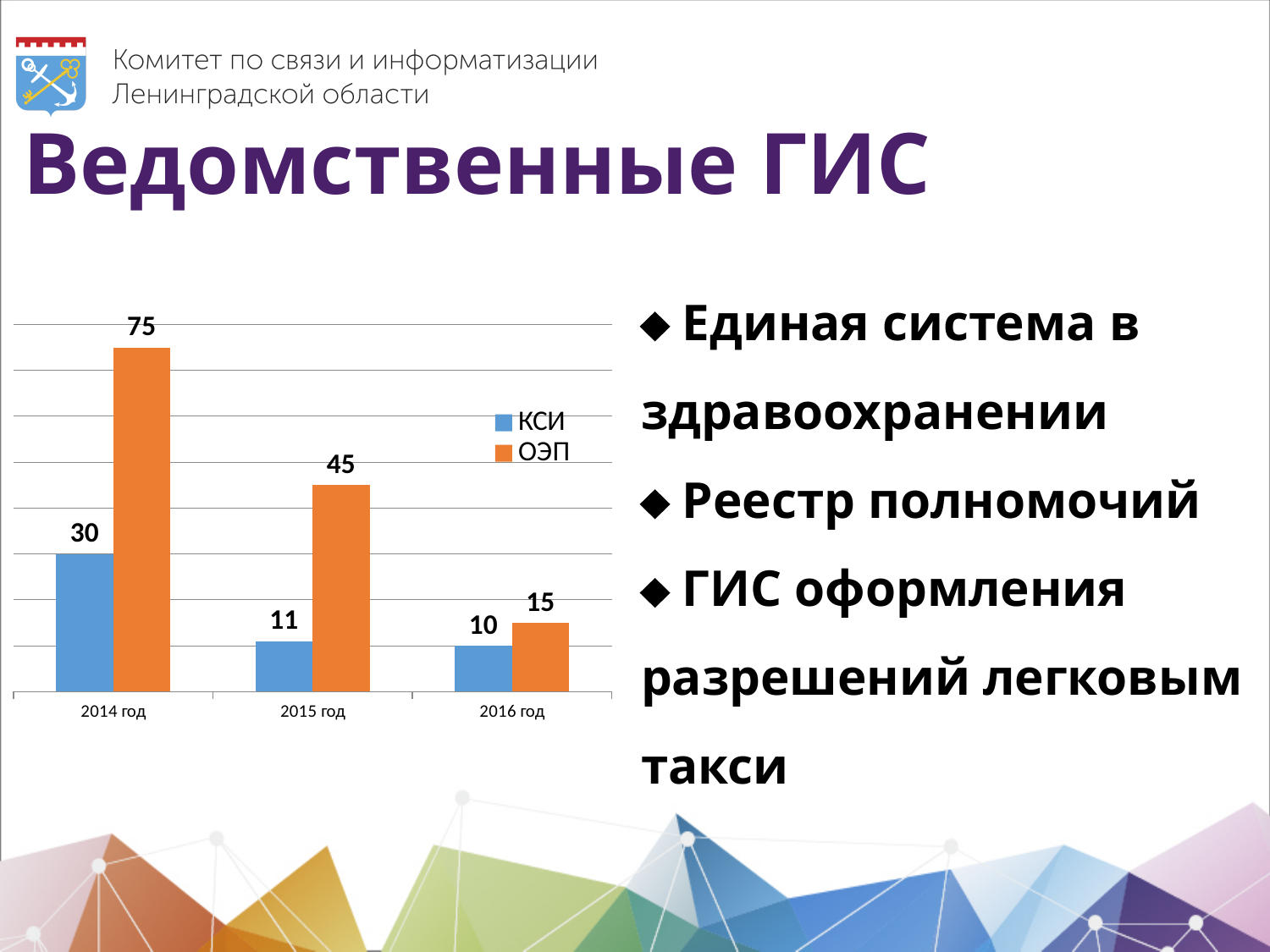
Do the ОЭП values rise or fall from 2014 год to 2016 год? fall What kind of chart is shown on the slide? bar chart How many years are shown on the x axis? 3 Which year has the highest value for ОЭП? 2014 год Which is larger in 2016 год, КСИ or ОЭП? ОЭП What is the difference between ОЭП and КСИ in 2014 год? 45 How many series does the legend list? 2 Which year has the lowest value for КСИ? 2016 год What is the value for ОЭП in 2016 год? 15 What is the value for КСИ in 2014 год? 30 What is the value for КСИ in 2015 год? 11 What is the value for ОЭП in 2015 год? 45